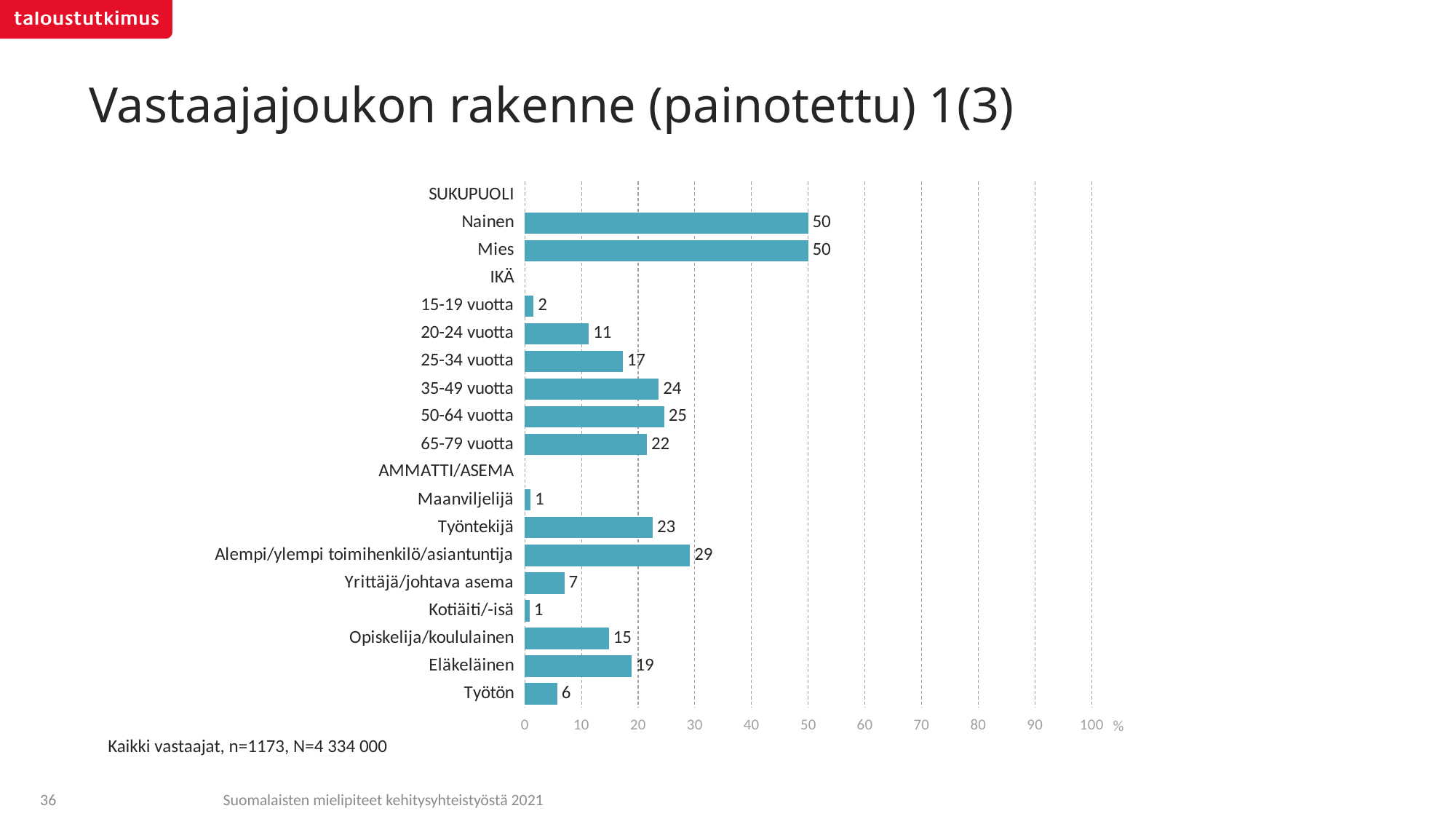
Which is larger, the value for Opiskelija/koululainen or the value for Työtön? Opiskelija/koululainen Which category under AMMATTI/ASEMA has the highest value? Alempi/ylempi toimihenkilö/asiantuntija What is the value for Alempi/ylempi toimihenkilö/asiantuntija? 29 What is the value for Eläkeläinen? 19 What is the difference between the values for Työntekijä and Yrittäjä/johtava asema? 16 What kind of chart is shown on the slide? bar chart What is the value for 35-49 vuotta? 24 Which age group (IKÄ) has the lowest value? 15-19 vuotta What is the title of the slide? Vastaajajoukon rakenne (painotettu) 1(3) Is the value for 65-79 vuotta greater or less than 30? less What is the value for Nainen? 50 Which age group (IKÄ) has the highest value? 50-64 vuotta